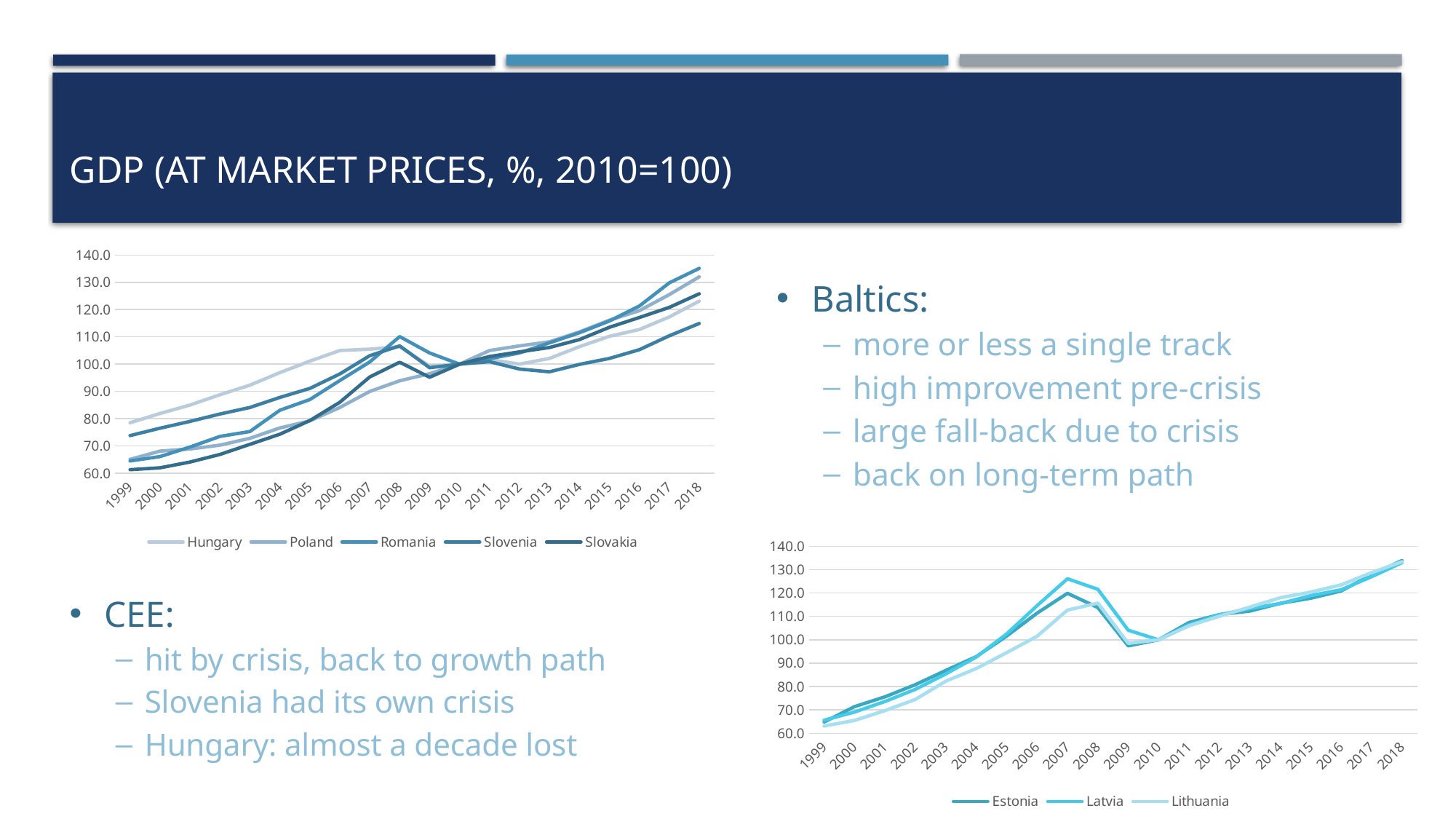
In the left chart, is the value for Romania in 2018 greater or less than 130? greater How many series does the legend of the right chart list? 3 How many years are shown on the x axis of the right chart? 20 In the left chart, is the value for Slovakia in 1999 greater or less than 70? less In the right chart, is the value for Latvia in 2007 greater or less than 120? greater In the right chart, do the values for Lithuania generally rise or fall from 2010 to 2018? rise What kind of chart is the chart on the left of the slide? line chart How many series does the legend of the left chart list? 5 In the left chart, which series has the highest value in 1999? Hungary In the right chart, which is higher in 2007, Latvia or Lithuania? Latvia In the left chart, which series has the highest value in 2018? Romania